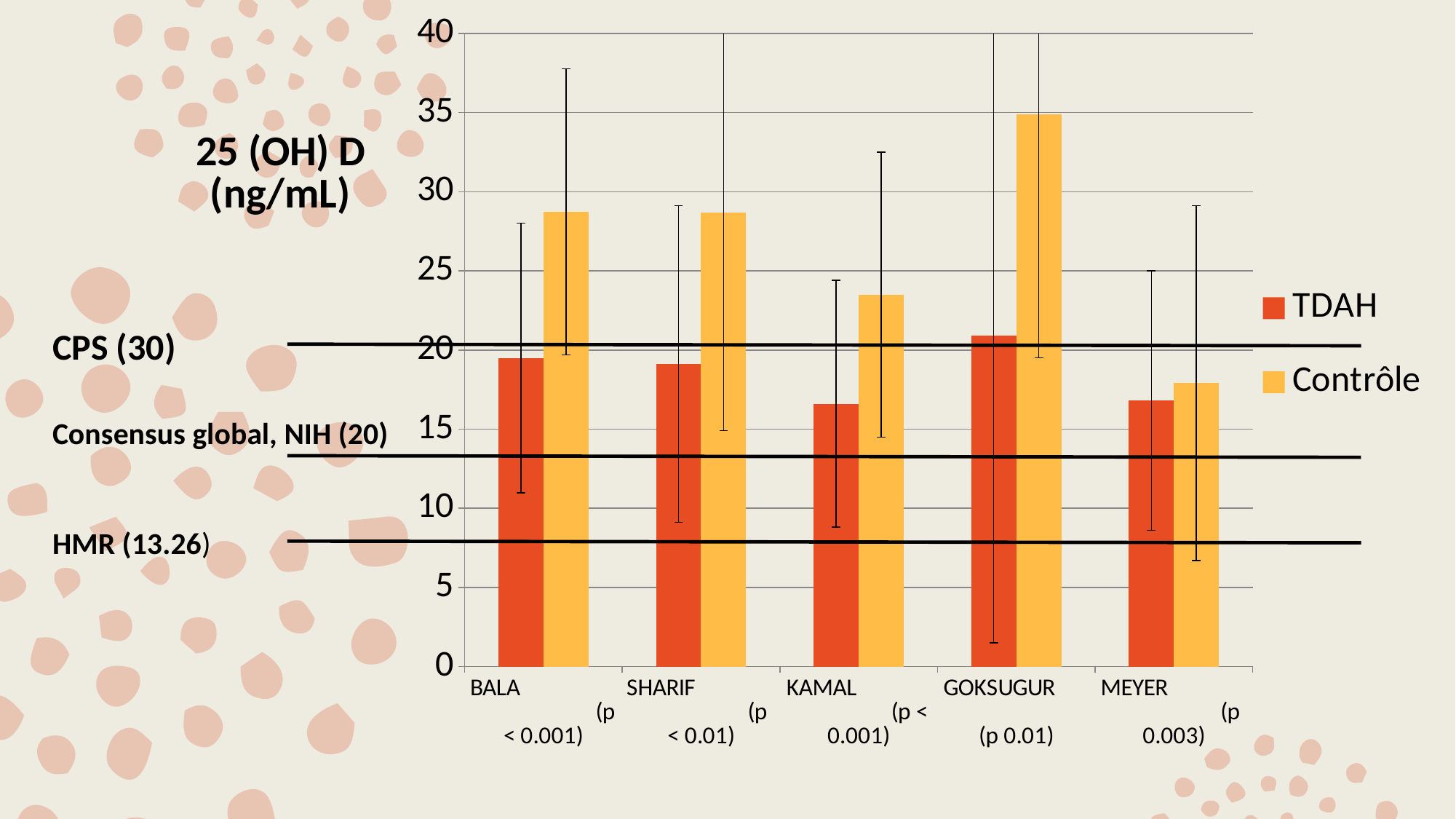
Which study has the lowest Contrôle value? MEYER For BALA, which is larger, the TDAH value or the Contrôle value? Contrôle Which study has the highest TDAH value? GOKSUGUR Is the Contrôle value for GOKSUGUR greater or less than 30? greater What kind of chart is shown on the slide? bar chart How many series does the legend list? 2 How many studies (categories) are shown along the x axis? 5 Which study has the highest Contrôle value? GOKSUGUR What quantity and unit does the y axis represent? 25 (OH) D (ng/mL) What are the two series named in the legend? TDAH and Contrôle Is the TDAH value for KAMAL greater or less than 20? less Is the Contrôle value for MEYER greater or less than 20? less